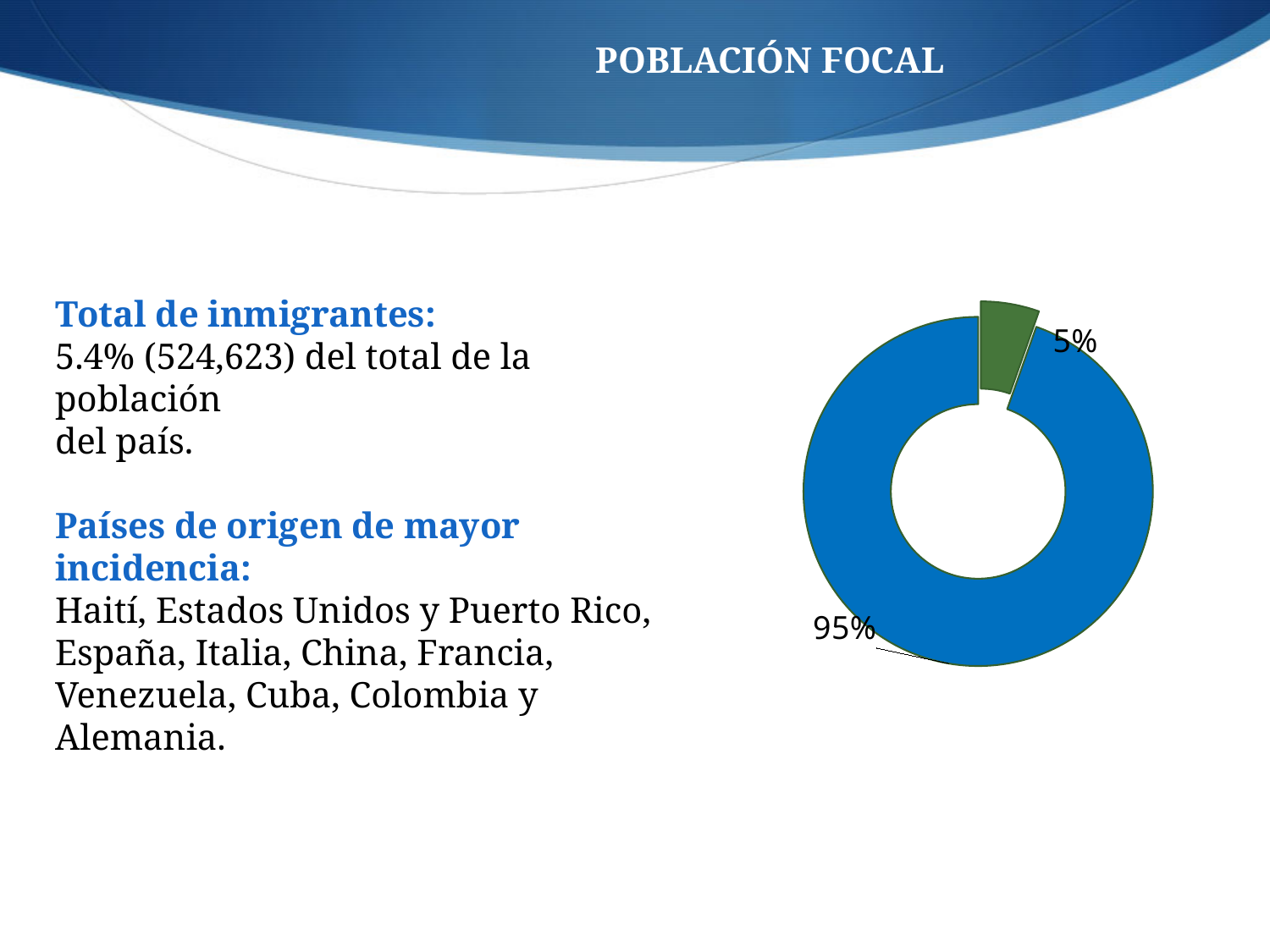
What share of the doughnut chart does the blue slice represent? 95% Which is larger, the blue slice or the green slice? the blue slice What is the difference in percentage points between the blue slice and the green slice? 90 Which slice of the doughnut chart is the smallest? the green slice (5%) What do the two slices of the doughnut chart add up to? 100% What kind of chart is shown on the slide? doughnut chart How many slices does the doughnut chart have? 2 What share of the doughnut chart does the green slice represent? 5% What colour is the slice labelled 5%? green Does the doughnut chart have a legend? No Which slice of the doughnut chart is the largest? the blue slice (95%)